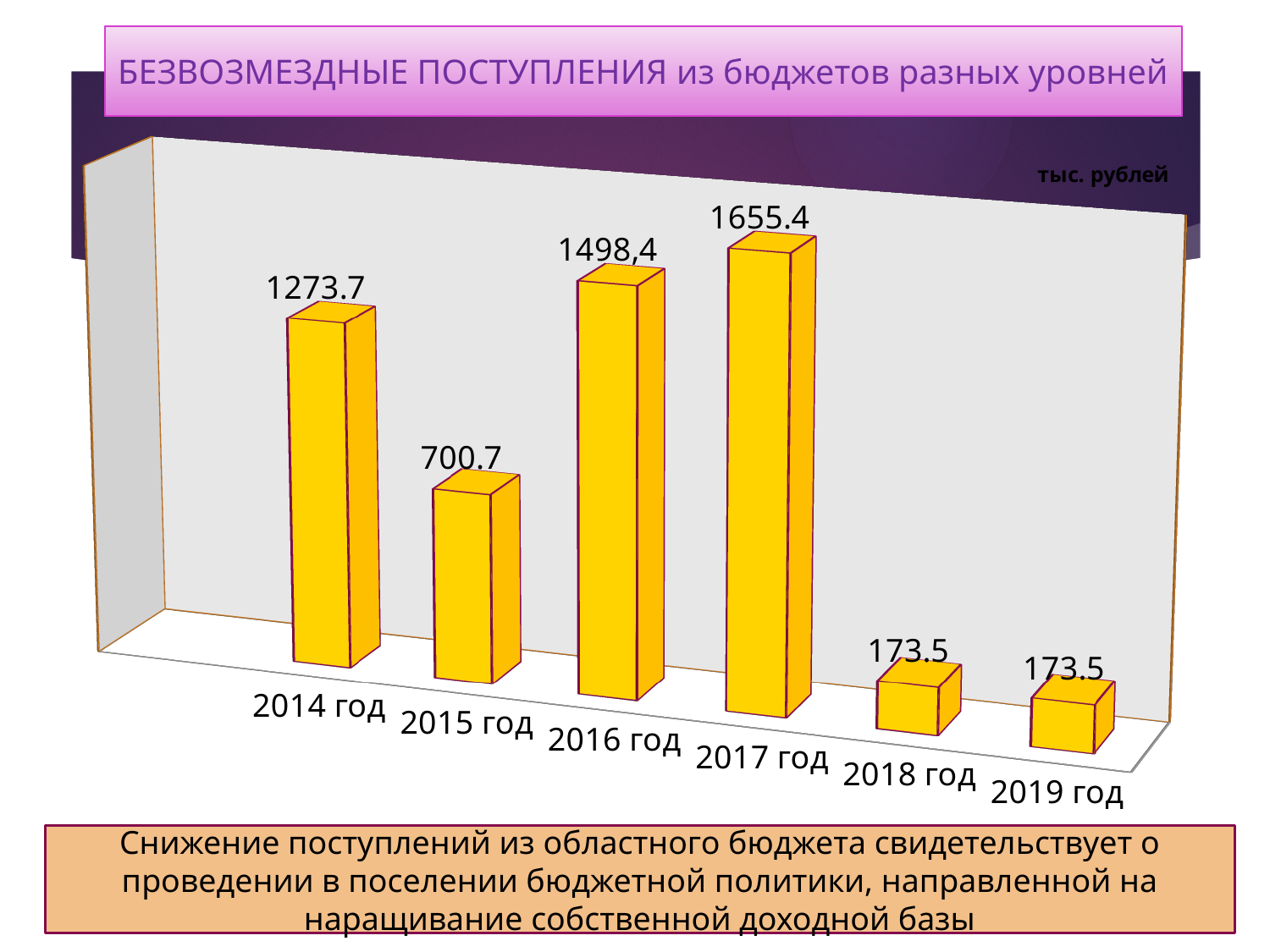
How many years are shown on the chart? 6 What is the difference between the values for 2017 год and 2014 год? 381.7 Which two years share the lowest value? 2018 год and 2019 год What is the value for 2016 год? 1498,4 What is the value for 2018 год? 173.5 What kind of chart is shown on the slide? bar chart What is the difference between the values for 2014 год and 2015 год? 573.0 What unit of measurement is indicated on the chart? тыс. рублей What is the value for 2015 год? 700.7 What is the value for 2014 год? 1273.7 Which is larger, the value for 2016 год or the value for 2014 год? 2016 год Which year has the highest value? 2017 год